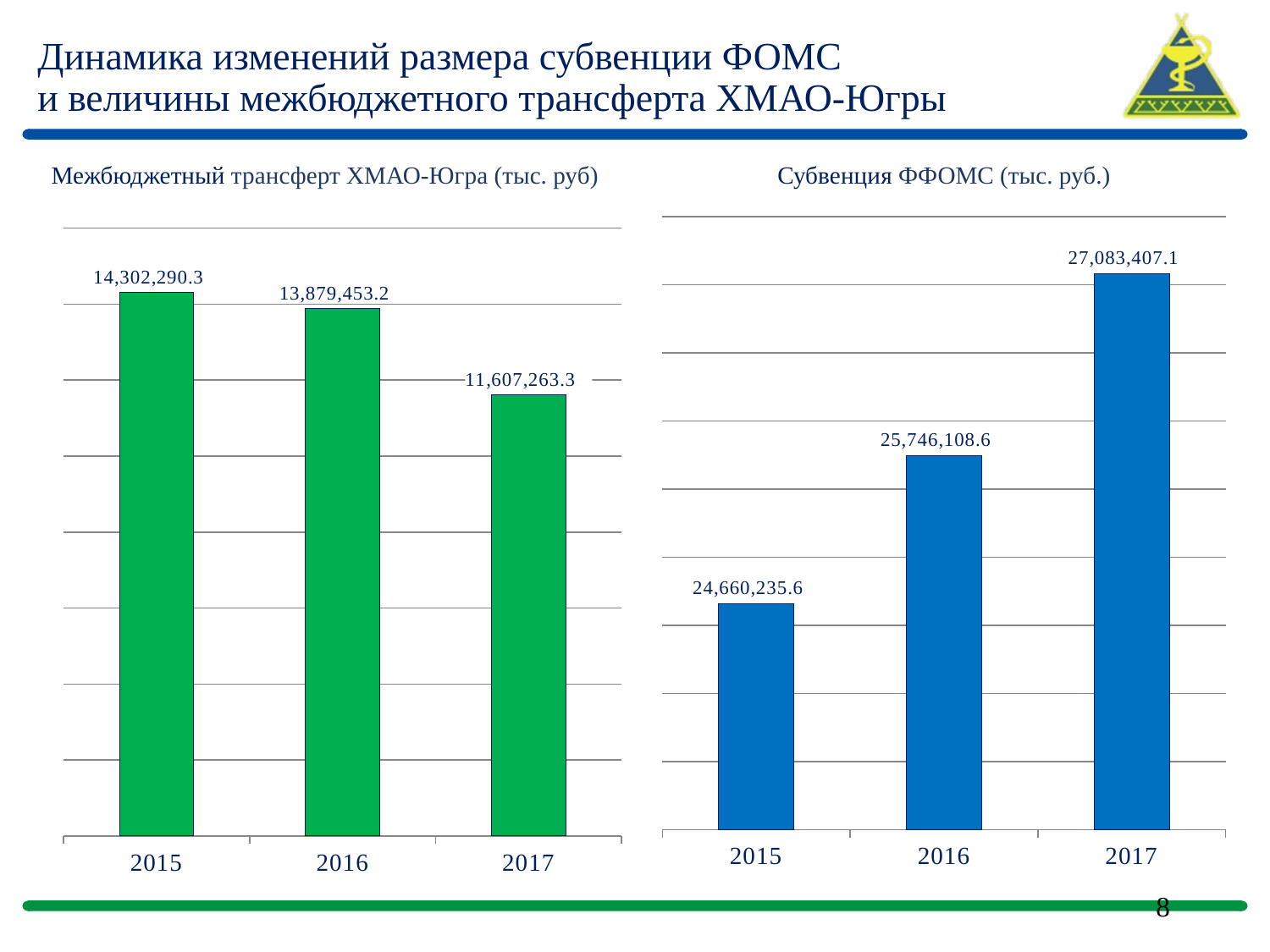
In the chart titled 'Субвенция ФФОМС (тыс. руб.)', how many years are plotted? 3 In the chart titled 'Субвенция ФФОМС (тыс. руб.)', what is the difference between the 2017 and 2016 values? 1,337,298.5 In the chart titled 'Межбюджетный трансферт ХМАО-Югра (тыс. руб)', what is the value for 2015? 14,302,290.3 In the chart titled 'Межбюджетный трансферт ХМАО-Югра (тыс. руб)', which year has the lowest value? 2017 In the chart titled 'Межбюджетный трансферт ХМАО-Югра (тыс. руб)', what is the difference between the 2016 and 2017 values? 2,272,189.9 In the chart titled 'Межбюджетный трансферт ХМАО-Югра (тыс. руб)', what is the value for 2017? 11,607,263.3 In the chart titled 'Субвенция ФФОМС (тыс. руб.)', what is the value for 2015? 24,660,235.6 In the chart titled 'Межбюджетный трансферт ХМАО-Югра (тыс. руб)', do the values rise or fall from 2015 to 2017? fall In the chart titled 'Субвенция ФФОМС (тыс. руб.)', which is larger, the value for 2015 or the value for 2016? 2016 In the chart titled 'Субвенция ФФОМС (тыс. руб.)', what is the value for 2016? 25,746,108.6 In the chart titled 'Субвенция ФФОМС (тыс. руб.)', which year has the highest value? 2017 What kind of chart is the chart on the left of the slide? bar chart